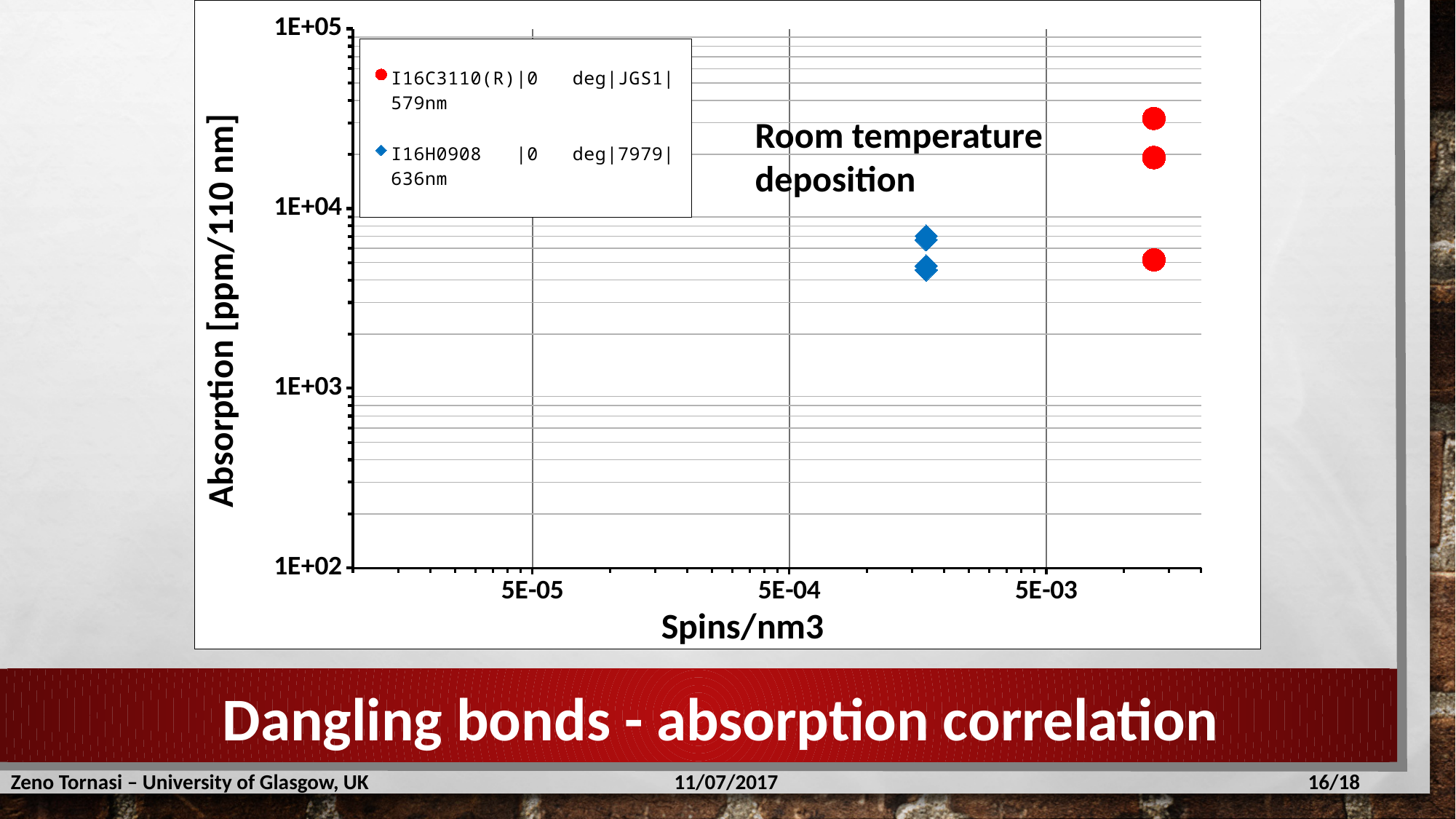
Are the absorption values of the blue diamond points greater or less than 1E+04? less How many series does the legend list? 2 Is the absorption value of the highest red circle point greater or less than 1E+04? greater Which series reaches the highest absorption value, the red circles (I16C3110(R)) or the blue diamonds (I16H0908)? red circles (I16C3110(R)) What text annotation is written inside the plot area? Room temperature deposition Is the Spins/nm3 value of the blue diamond points greater or less than 5E-03? less What kind of chart is shown on the slide? scatter chart What is the label of the y axis? Absorption [ppm/110 nm]